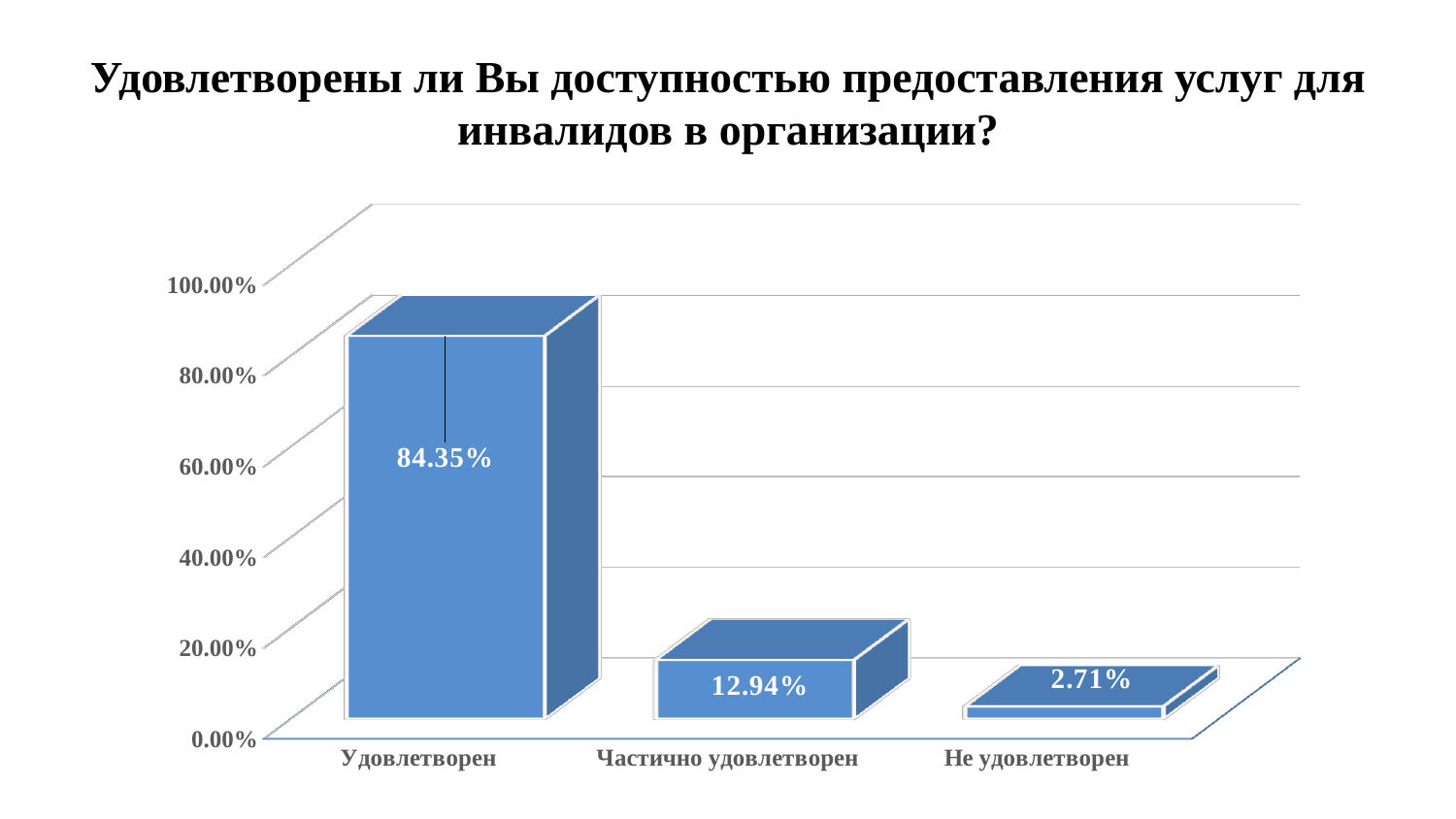
What is the value for Не удовлетворен? 2.71% What is the value for Частично удовлетворен? 12.94% How many categories are shown on the chart? 3 What is the value for Удовлетворен? 84.35% Is the value for Удовлетворен greater or less than 80.00%? greater What is the difference between the values for Частично удовлетворен and Не удовлетворен? 10.23% What is the title of the chart? Удовлетворены ли Вы доступностью предоставления услуг для инвалидов в организации? What kind of chart is shown on the slide? bar chart Which is larger, the value for Частично удовлетворен or the value for Не удовлетворен? Частично удовлетворен Which category has the lowest value? Не удовлетворен Which category has the highest value? Удовлетворен What is the difference between the values for Удовлетворен and Частично удовлетворен? 71.41%